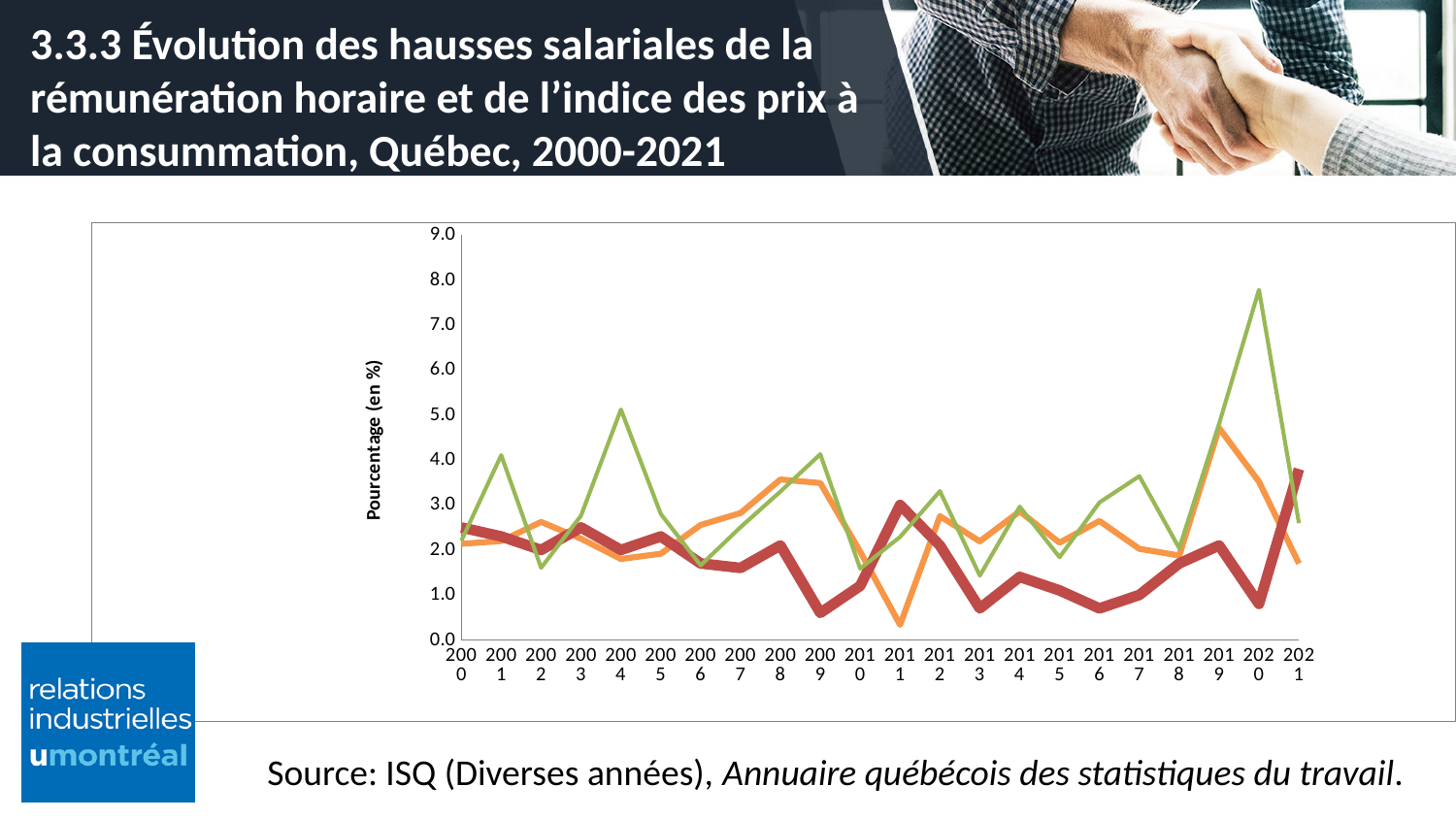
What is the label of the vertical axis? Pourcentage (en %) How many years are shown along the x axis of the chart? 22 Is the value of the green line in 2020 greater or less than 7.0? greater In which year does the green line reach its highest value? 2020 In which year does the orange line reach its lowest value? 2011 Is the value of the orange line in 2019 greater or less than 4.0? greater Does the green line rise or fall from 2020 to 2021? fall How many lines are plotted on the chart? 3 Is the value of the orange line in 2011 greater or less than 1.0? less In 2020, which line has the larger value, the green line or the red line? green line What kind of chart is shown on the slide? line chart